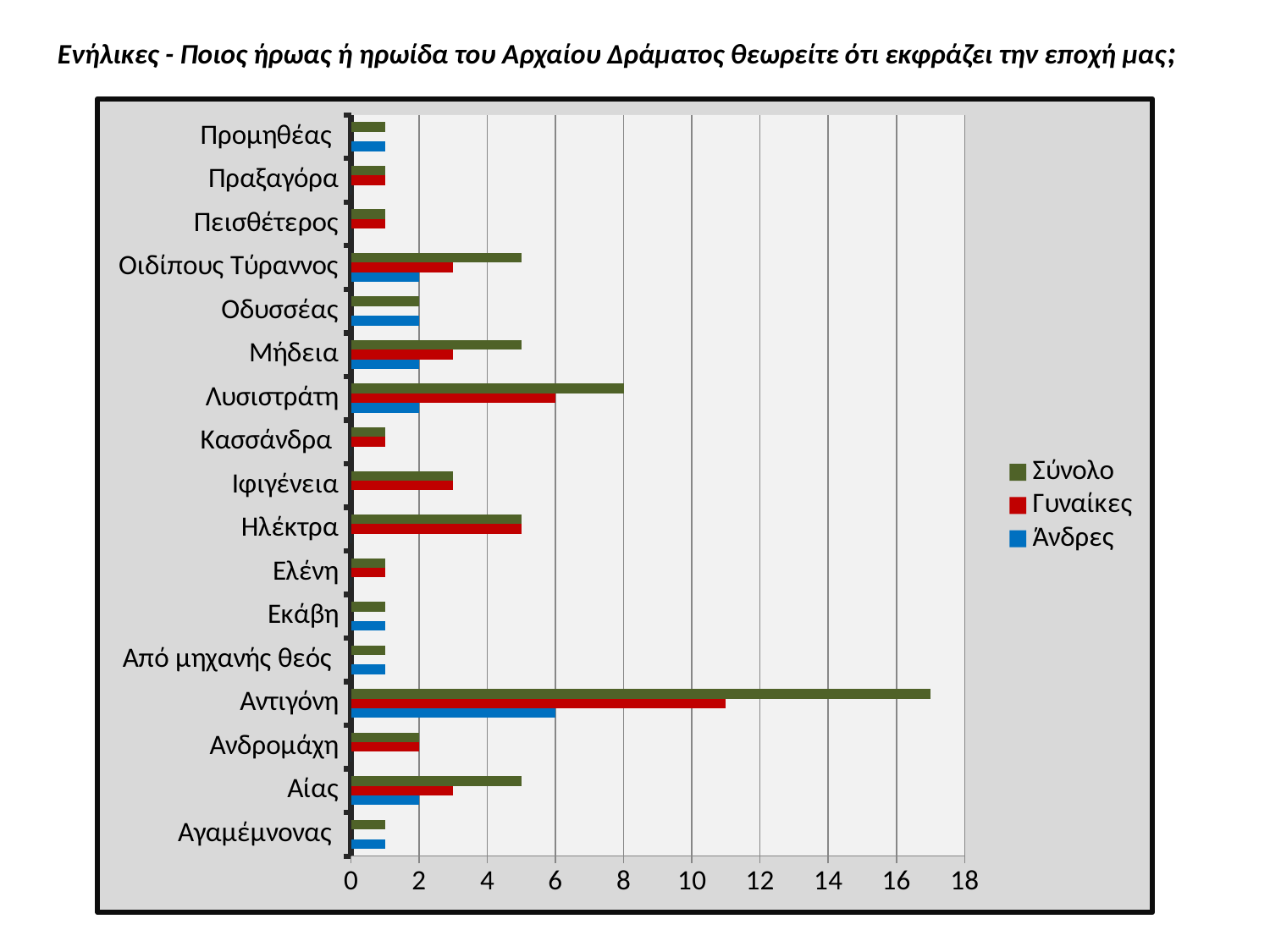
What is the Σύνολο value for Λυσιστράτη? 8 Which colour represents the Σύνολο series in the legend? Green Which has the larger Σύνολο value, Λυσιστράτη or Μήδεια? Λυσιστράτη Is the Σύνολο value for Αντιγόνη greater or less than 16? greater What is the difference between the Σύνολο and Γυναίκες values for Λυσιστράτη? 2 What kind of chart is shown on the slide? Bar chart How many series does the legend list? 3 What is the Σύνολο value for Οδυσσέας? 2 Which category has the highest Σύνολο value? Αντιγόνη What is the Γυναίκες value for Λυσιστράτη? 6 How many heroes/heroines (categories) are shown on the chart? 17 What is the Άνδρες value for Αντιγόνη? 6